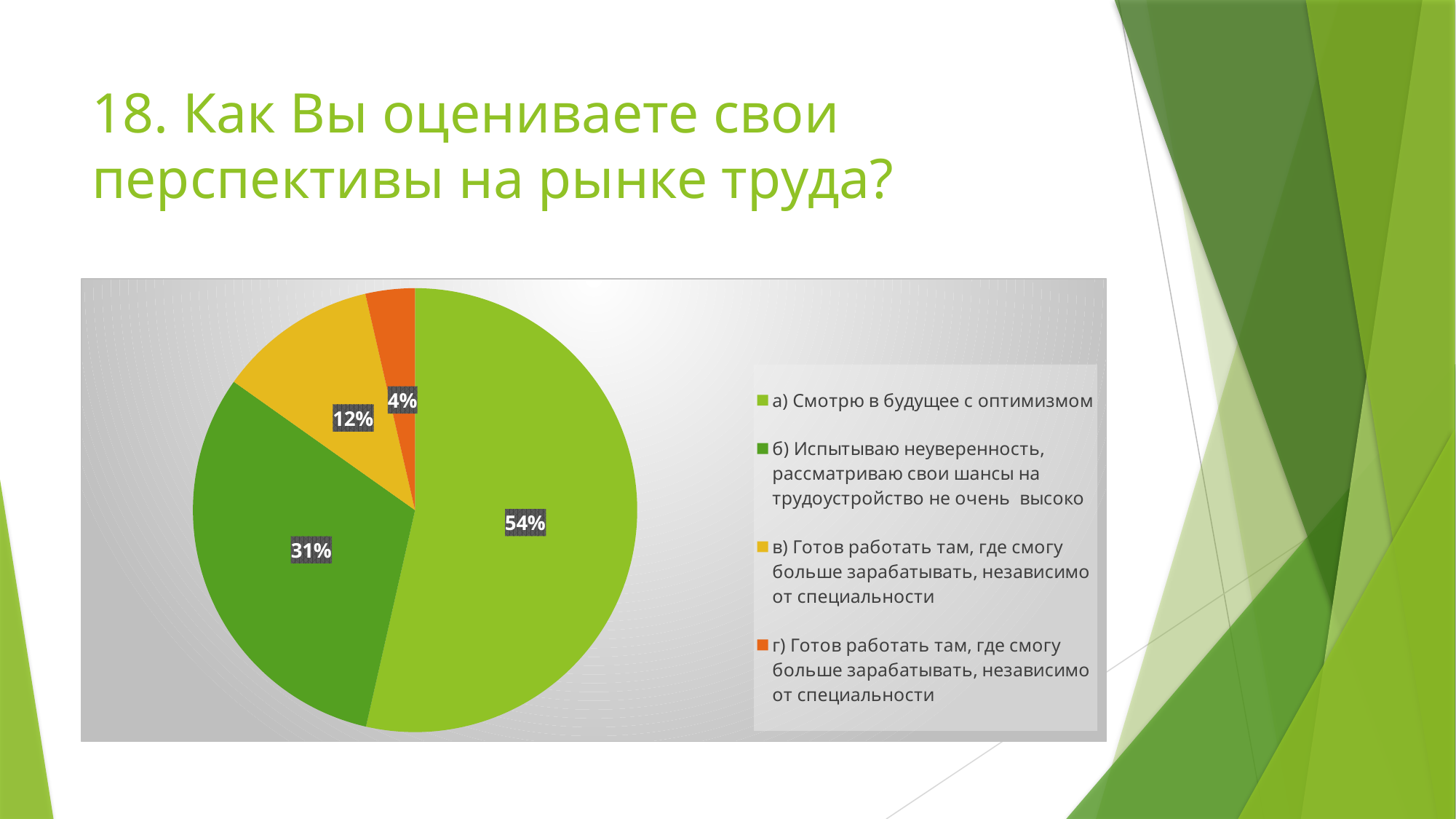
What colour is the slice for option а) Смотрю в будущее с оптимизмом? Light green How many slices does the pie chart have? 4 What percentage is shown for the orange slice, option г)? 4% Which option has the smallest share of the pie? г) (the orange slice, 4%) Which is larger: the share for option б) or the share for option в)? б) What is the combined share of options в) and г)? 16% Which option has the largest share of the pie? а) Смотрю в будущее с оптимизмом What is the difference in percentage points between option а) and option б)? 23 What percentage is shown for option б) Испытываю неуверенность, рассматриваю свои шансы на трудоустройство не очень высоко? 31% What percentage is shown for the yellow slice, option в)? 12% What share of the pie does option а) Смотрю в будущее с оптимизмом take? 54% What kind of chart is shown on the slide? Pie chart